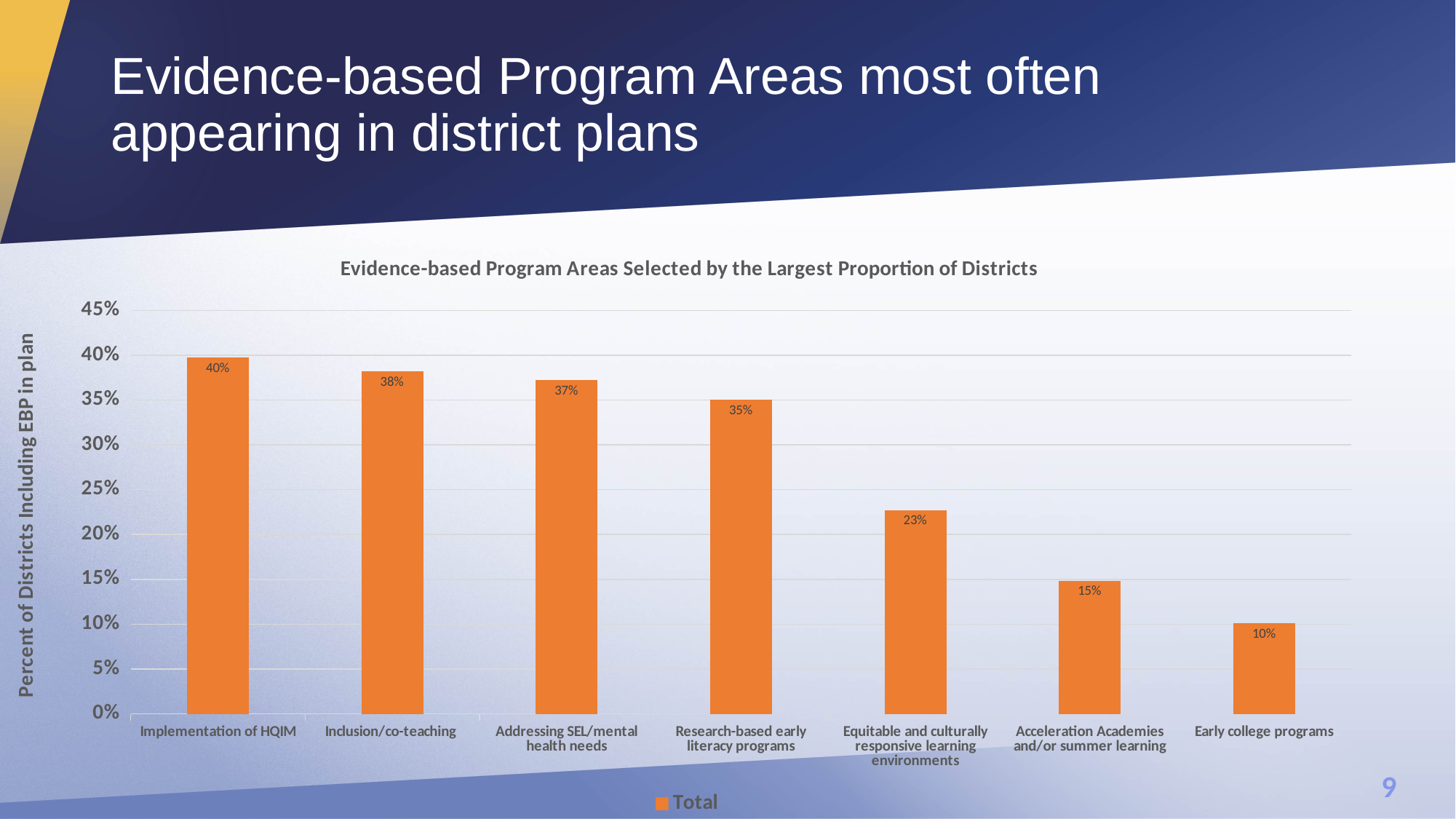
Which program area has the lowest percent of districts including it in their plan? Early college programs Which program area has the highest percent of districts including it in their plan? Implementation of HQIM What kind of chart is shown on the slide? bar chart What is the value for Research-based early literacy programs? 35% How many series does the legend list? 1 Is the value for Equitable and culturally responsive learning environments greater or less than 25%? less What is the difference between the values for Inclusion/co-teaching and Early college programs? 28% What percent of districts included Implementation of HQIM in their plan? 40% What is the title of the chart? Evidence-based Program Areas Selected by the Largest Proportion of Districts How many program areas are shown on the chart? 7 What is the value for Acceleration Academies and/or summer learning? 15% Which is larger: the value for Addressing SEL/mental health needs or the value for Equitable and culturally responsive learning environments? Addressing SEL/mental health needs